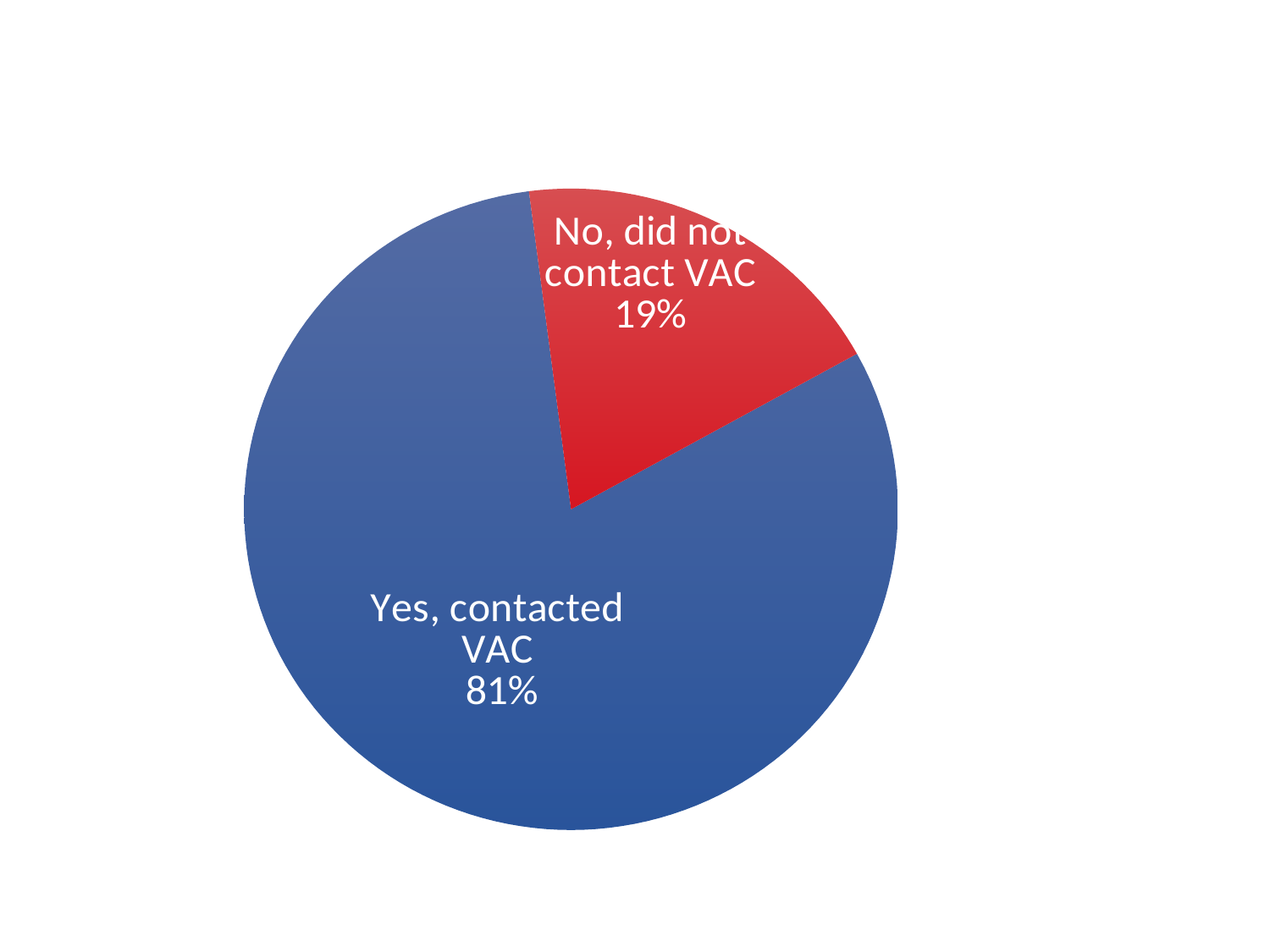
How many slices does the pie chart have? 2 What kind of chart is shown on the slide? Pie chart Which slice of the pie is the smallest? No, did not contact VAC What is the difference in percentage points between the "Yes, contacted VAC" slice and the "No, did not contact VAC" slice? 62 What share of the pie does the "No, did not contact VAC" slice represent? 19% What colour is the "No, did not contact VAC" slice? Red Which is larger: the share for "Yes, contacted VAC" or the share for "No, did not contact VAC"? Yes, contacted VAC Which slice of the pie is the largest? Yes, contacted VAC What percentage of the pie is labelled "Yes, contacted VAC"? 81% What colour is the "Yes, contacted VAC" slice? Blue What percentage of the pie is labelled "No, did not contact VAC"? 19%